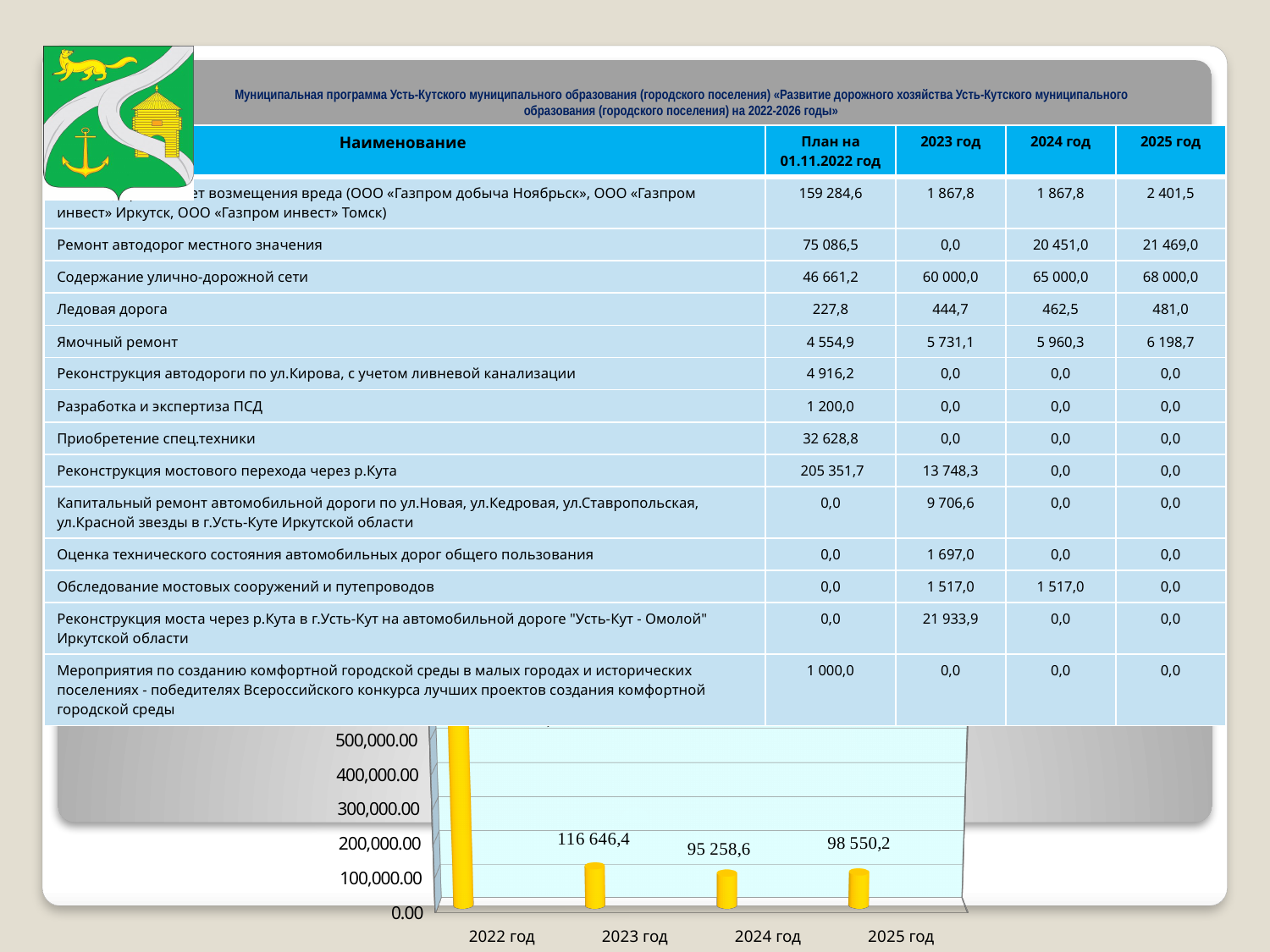
In the bar chart at the bottom of the slide, is the value for 2022 год greater or less than 400,000.00? greater In the bar chart at the bottom of the slide, what is the value for 2024 год? 95 258,6 How many years are shown on the x axis of the bar chart at the bottom of the slide? 4 In the bar chart at the bottom of the slide, what is the difference between the values for 2023 год and 2024 год? 21 387,8 What kind of chart is shown at the bottom of the slide? bar chart In the bar chart at the bottom of the slide, what is the value for 2025 год? 98 550,2 In the bar chart at the bottom of the slide, which year has the highest bar? 2022 год In the bar chart at the bottom of the slide, what is the difference between the values for 2025 год and 2024 год? 3 291,6 In the bar chart at the bottom of the slide, does the value rise or fall from 2022 год to 2023 год? fall In the bar chart at the bottom of the slide, which year has the lowest value? 2024 год In the bar chart at the bottom of the slide, what is the value for 2023 год? 116 646,4 In the bar chart at the bottom of the slide, which is larger, the value for 2023 год or the value for 2025 год? 2023 год